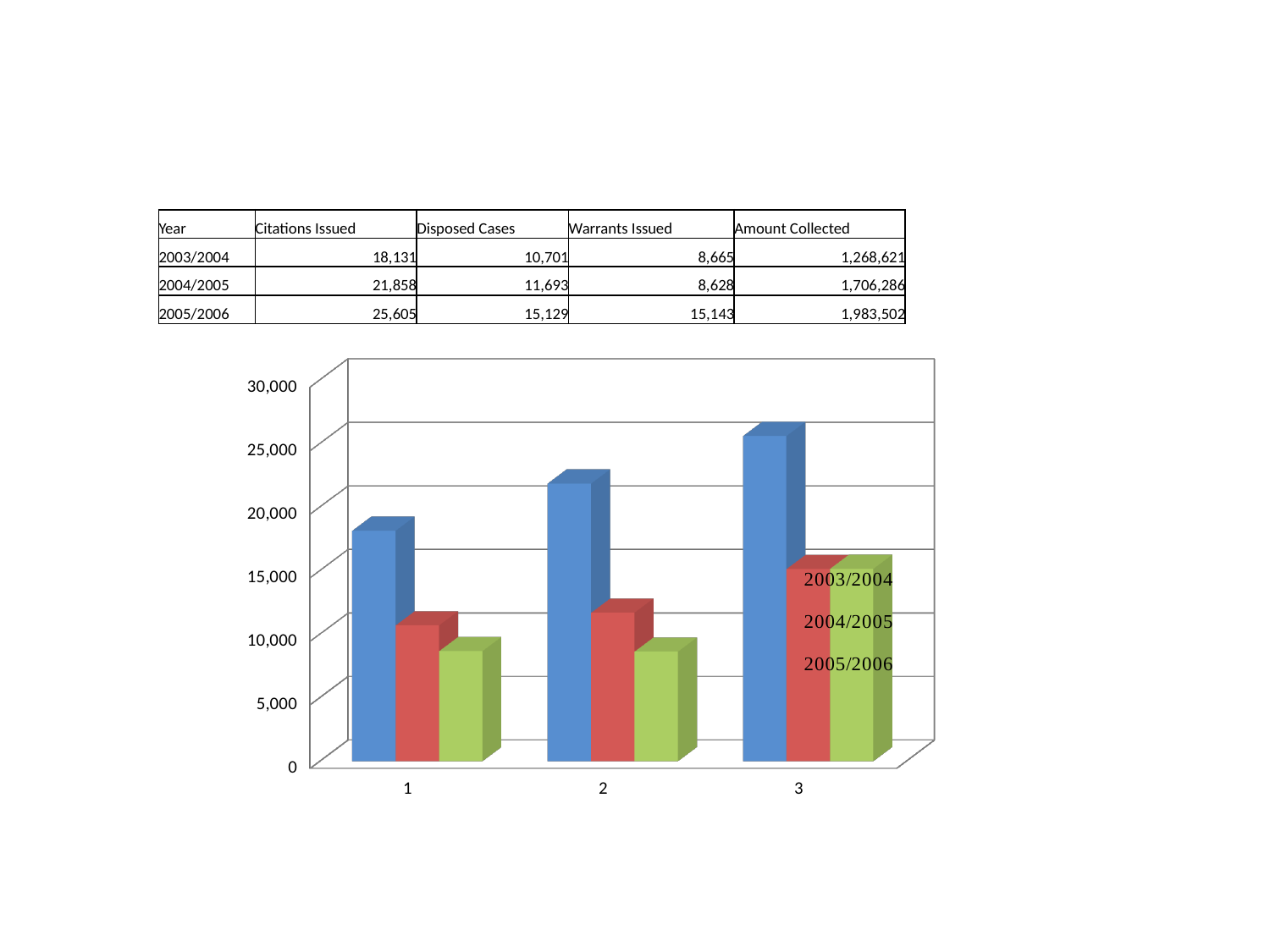
Is the value of the green bar for category 1 greater or less than 10,000? less How many categories are shown along the x axis of the chart? 3 Do the blue bars rise or fall from category 1 to category 3? rise What kind of chart is shown on the slide? bar chart Which category has the tallest blue bar? 3 Is the value of the blue bar for category 1 greater or less than 20,000? less In category 1, which is larger, the blue bar or the green bar? blue bar Is the value of the green bar for category 3 greater or less than 10,000? greater